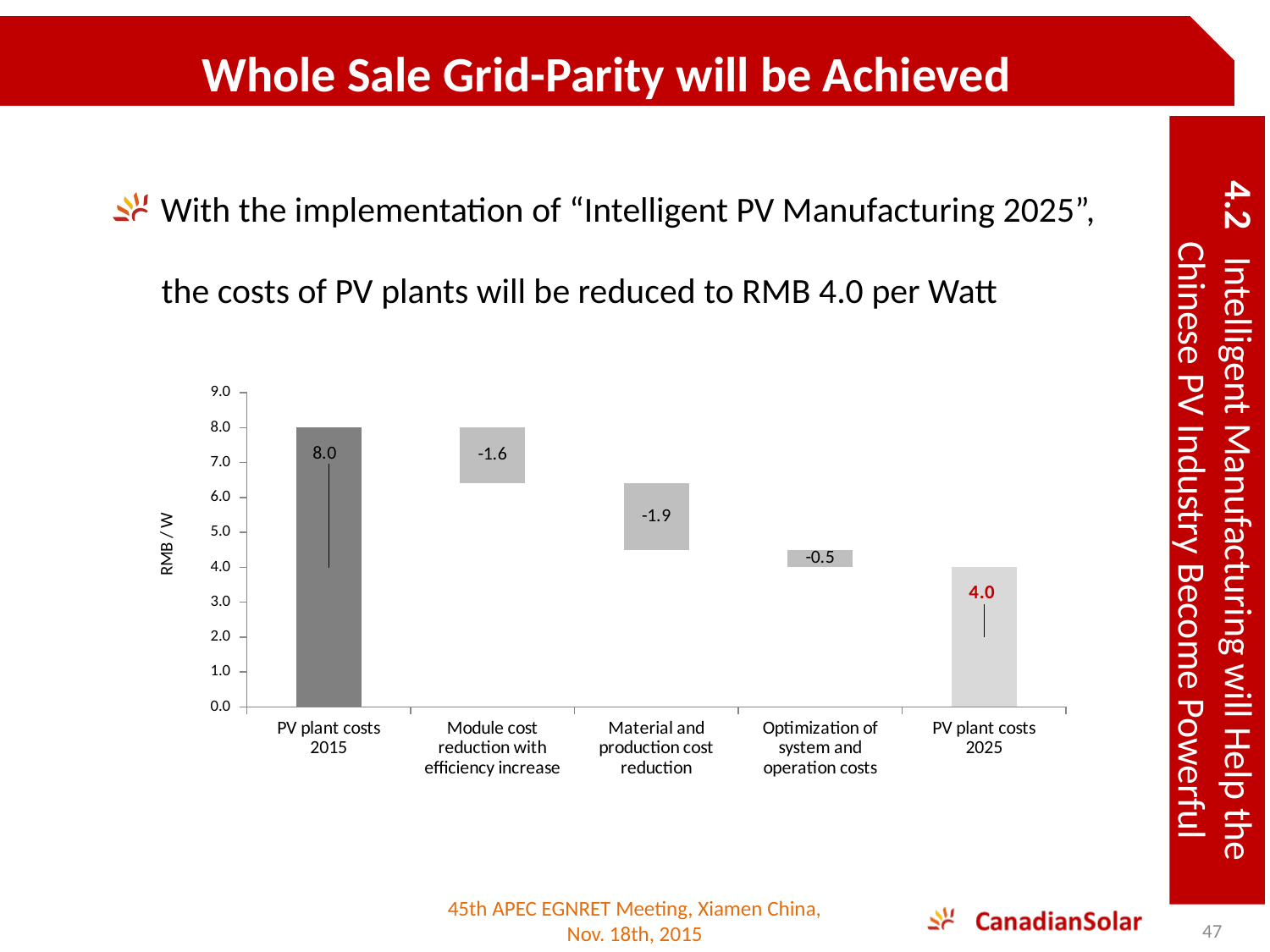
What reduction is shown for Material and production cost reduction? -1.9 What reduction is shown for Optimization of system and operation costs? -0.5 Which is larger in magnitude, the Module cost reduction with efficiency increase or the Material and production cost reduction? Material and production cost reduction What is the label of the y axis of the chart? RMB / W What is the value shown for PV plant costs 2025? 4.0 What reduction is shown for Module cost reduction with efficiency increase? -1.6 How many categories are shown on the x axis of the chart? 5 What is the difference between PV plant costs 2015 and PV plant costs 2025? 4.0 Which of the three cost reduction steps has the smallest reduction? Optimization of system and operation costs What is the value shown for PV plant costs 2015? 8.0 Is the value for PV plant costs 2025 greater or less than 5.0? less Which of the three cost reduction steps has the largest reduction? Material and production cost reduction